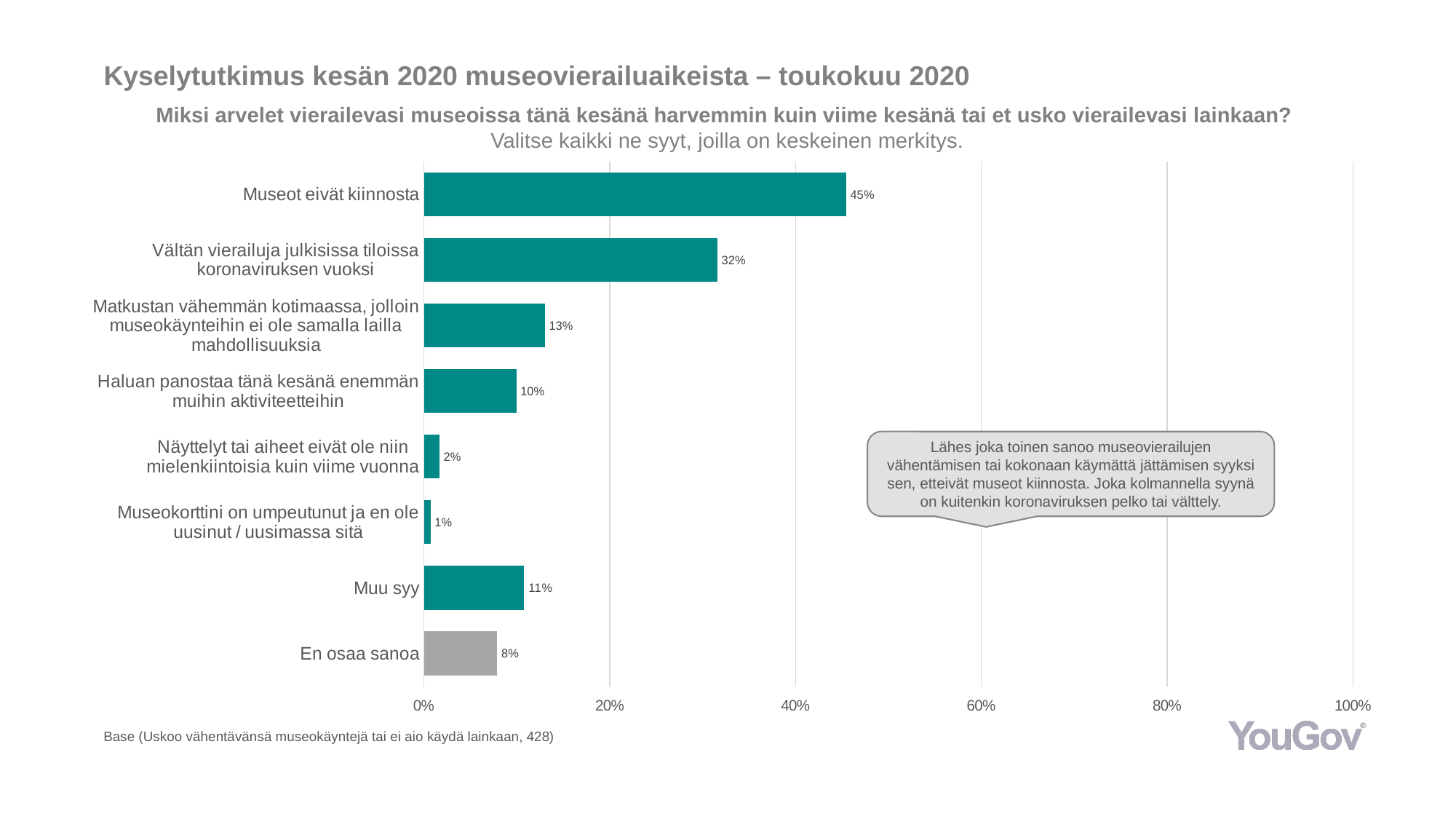
What kind of chart is shown on the slide? Bar chart What is the value for "Museot eivät kiinnosta"? 45% Which category has the lowest value? Museokorttini on umpeutunut ja en ole uusinut / uusimassa sitä What is the value for "Muu syy"? 11% Which bar is shown in a different colour (grey) from the others? En osaa sanoa Is the value for "Museot eivät kiinnosta" greater or less than 40%? greater What is the value for "Vältän vierailuja julkisissa tiloissa koronaviruksen vuoksi"? 32% Which category has the highest value? Museot eivät kiinnosta What is the difference between the values for "Museot eivät kiinnosta" and "Vältän vierailuja julkisissa tiloissa koronaviruksen vuoksi"? 13% How many categories are shown in the chart? 8 Which is larger: the value for "Muu syy" or the value for "Haluan panostaa tänä kesänä enemmän muihin aktiviteetteihin"? Muu syy What is the value for "En osaa sanoa"? 8%